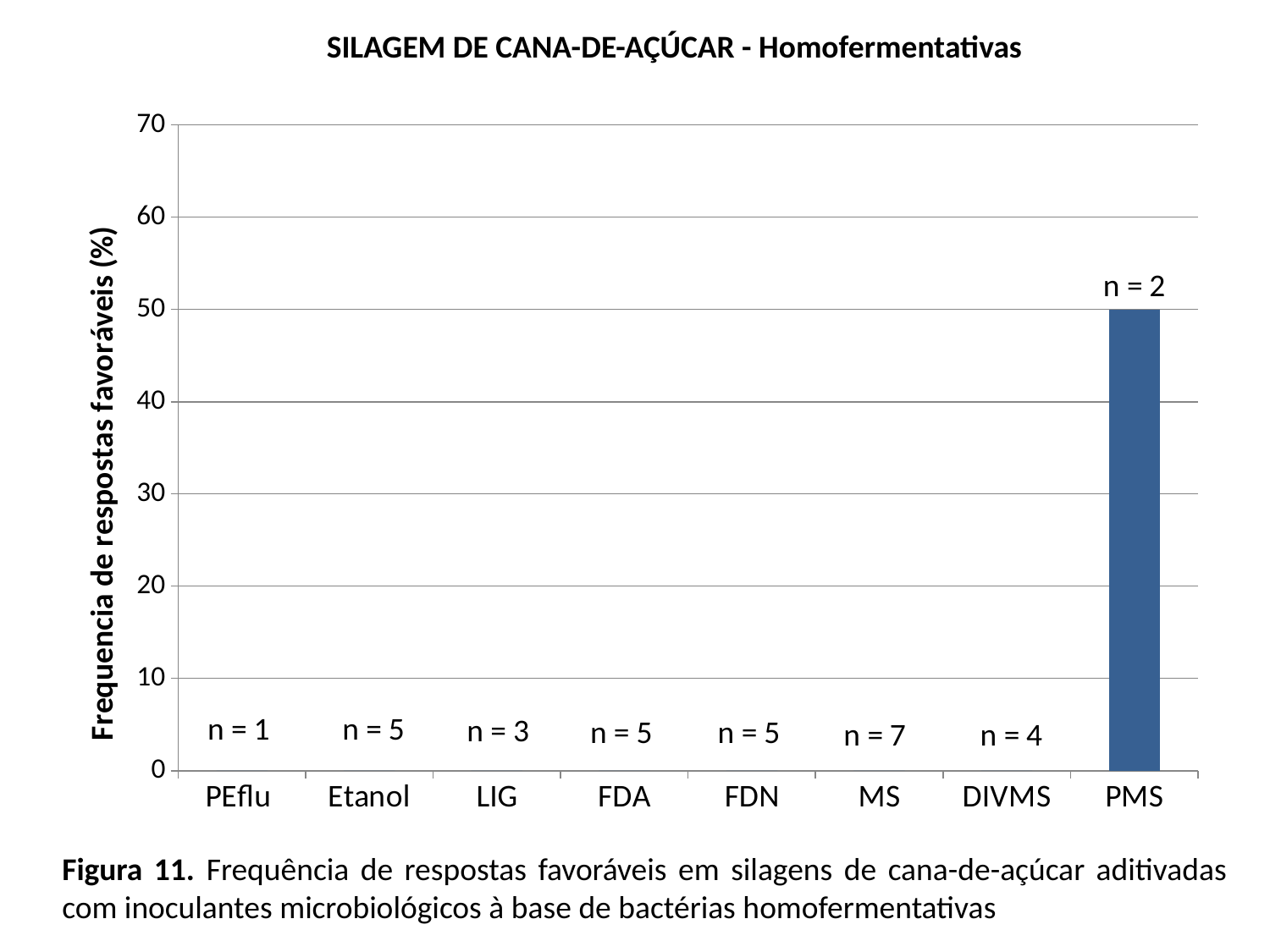
What kind of chart is shown on the slide? bar chart What is the label of the y axis? Frequencia de respostas favoráveis (%) Is the value for PMS greater or less than 60? less What is the highest value shown on the y axis? 70 Is the value for MS greater or less than 10? less Which category has the highest frequency of favourable responses? PMS Is the value for PMS greater or less than 40? greater What is the title of the chart? SILAGEM DE CANA-DE-AÇÚCAR - Homofermentativas What is the frequency of favourable responses (%) for PMS? 50 Which is larger, the value for PMS or the value for DIVMS? PMS How many categories are shown on the x axis of the chart? 8